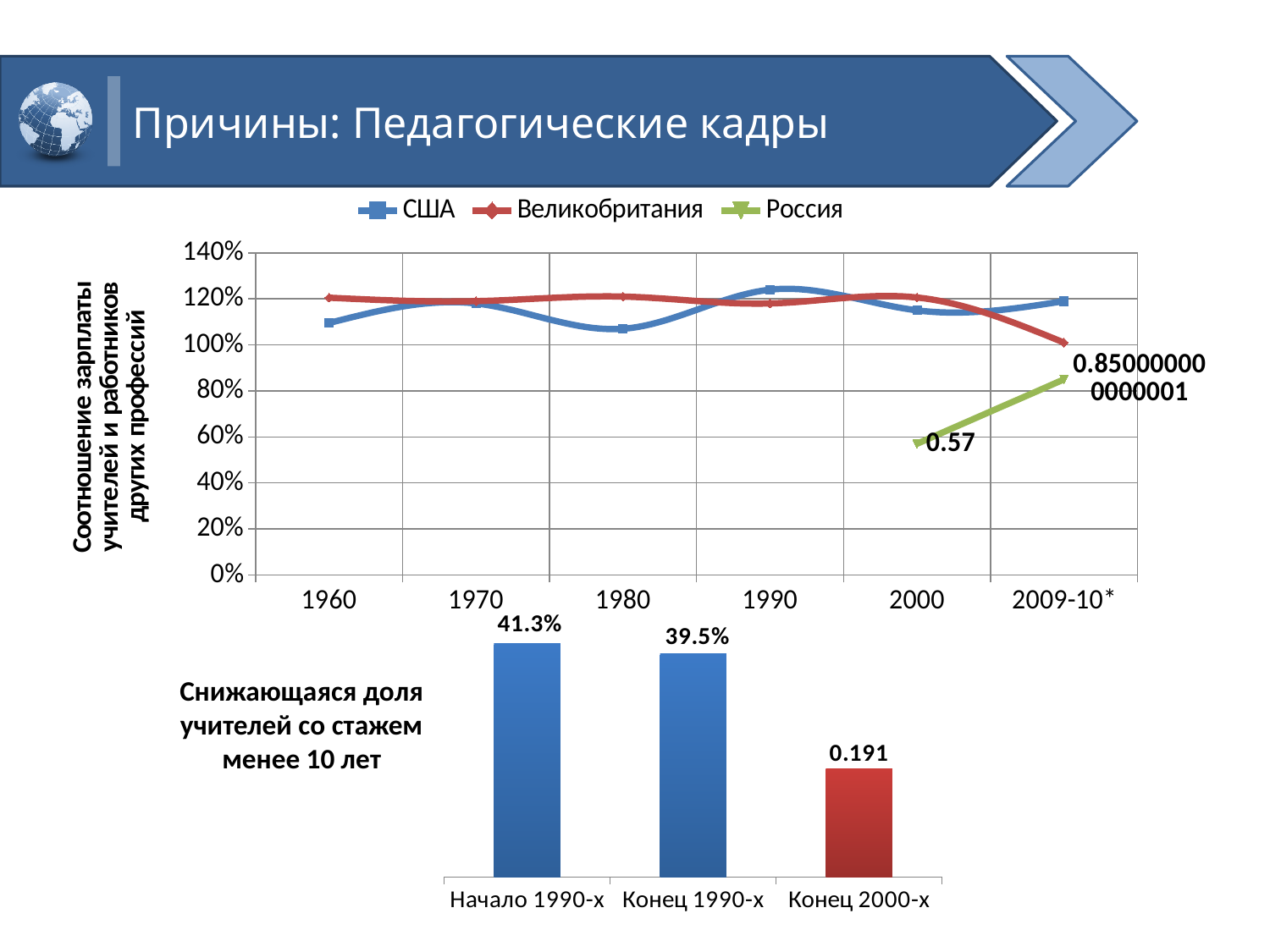
On the top chart, is the value for Великобритания in 2009-10* greater or less than 120%? less On the bottom chart, what is the value for Конец 2000-х? 0.191 On the bottom chart, what is the difference between Начало 1990-х and Конец 1990-х? 1.8% On the bottom chart, which category has the lowest value? Конец 2000-х On the bottom chart, what kind of chart is it? bar chart On the top line chart, how many series does the legend list? 3 On the top chart, how many points are shown on the x axis? 6 On the top chart, which series has the highest value at 2009-10*? США On the top chart, what is the value for Россия in 2009-10*? 0.850000000000001 On the top chart, is the value for США in 1960 greater or less than 100%? greater On the bottom chart, what is the value for Начало 1990-х? 41.3% On the top chart, what is the value for Россия in 2000? 0.57